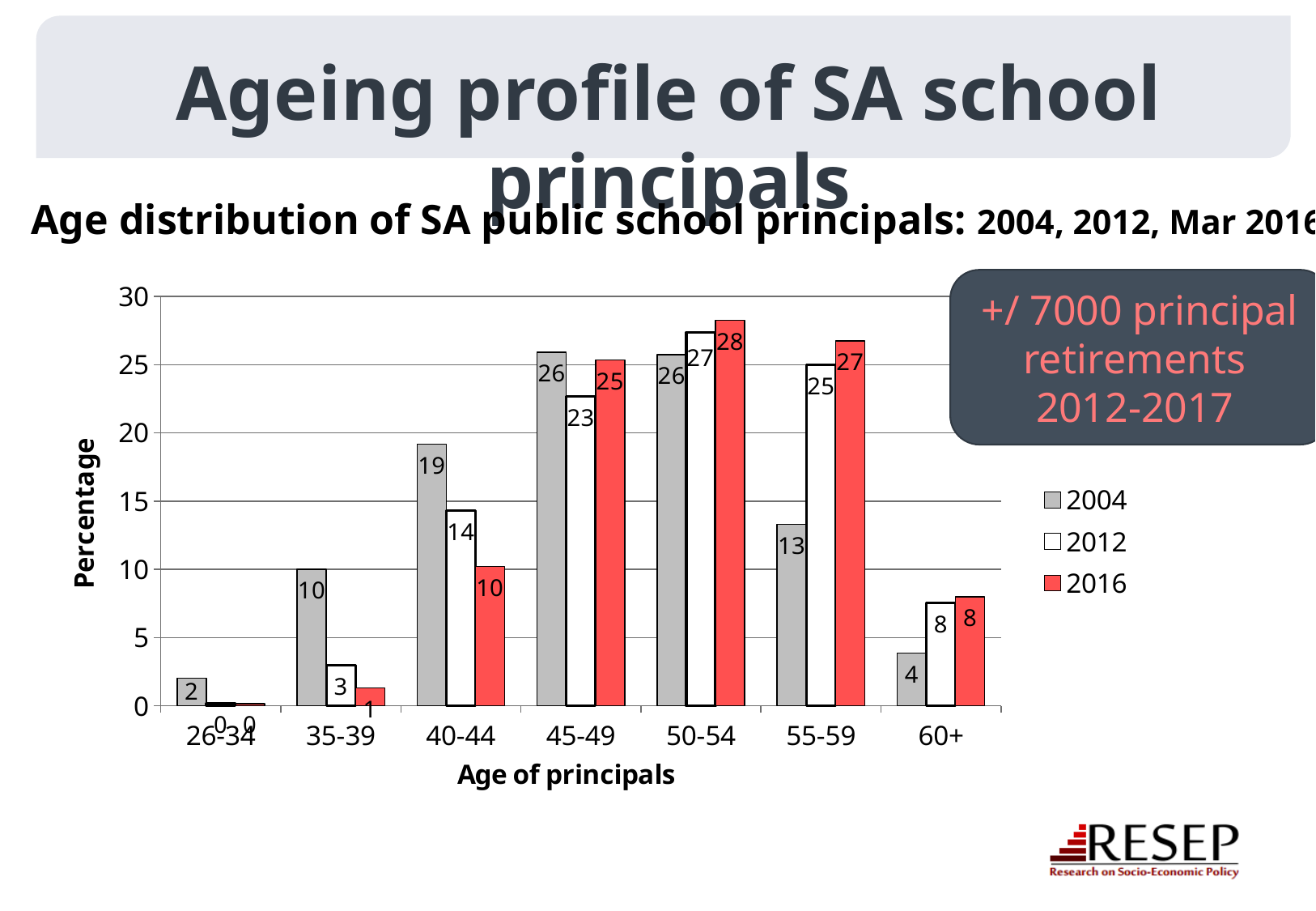
Do the 2016 values rise or fall from the 26-34 group to the 50-54 group? rise Which age group has the highest 2016 value? 50-54 What is the title of the y axis? Percentage How many series does the legend list? 3 How many age groups are shown on the x axis? 7 What kind of chart is shown on the slide? bar chart For the 55-59 age group, which is larger: the 2004 value or the 2012 value? 2012 Which age group has the lowest 2004 value? 26-34 What is the 2004 value for the 40-44 age group? 19 What is the 2016 value for the 55-59 age group? 27 What is the difference between the 2004 and 2016 values for the 40-44 age group? 9 What is the 2012 value for the 45-49 age group? 23